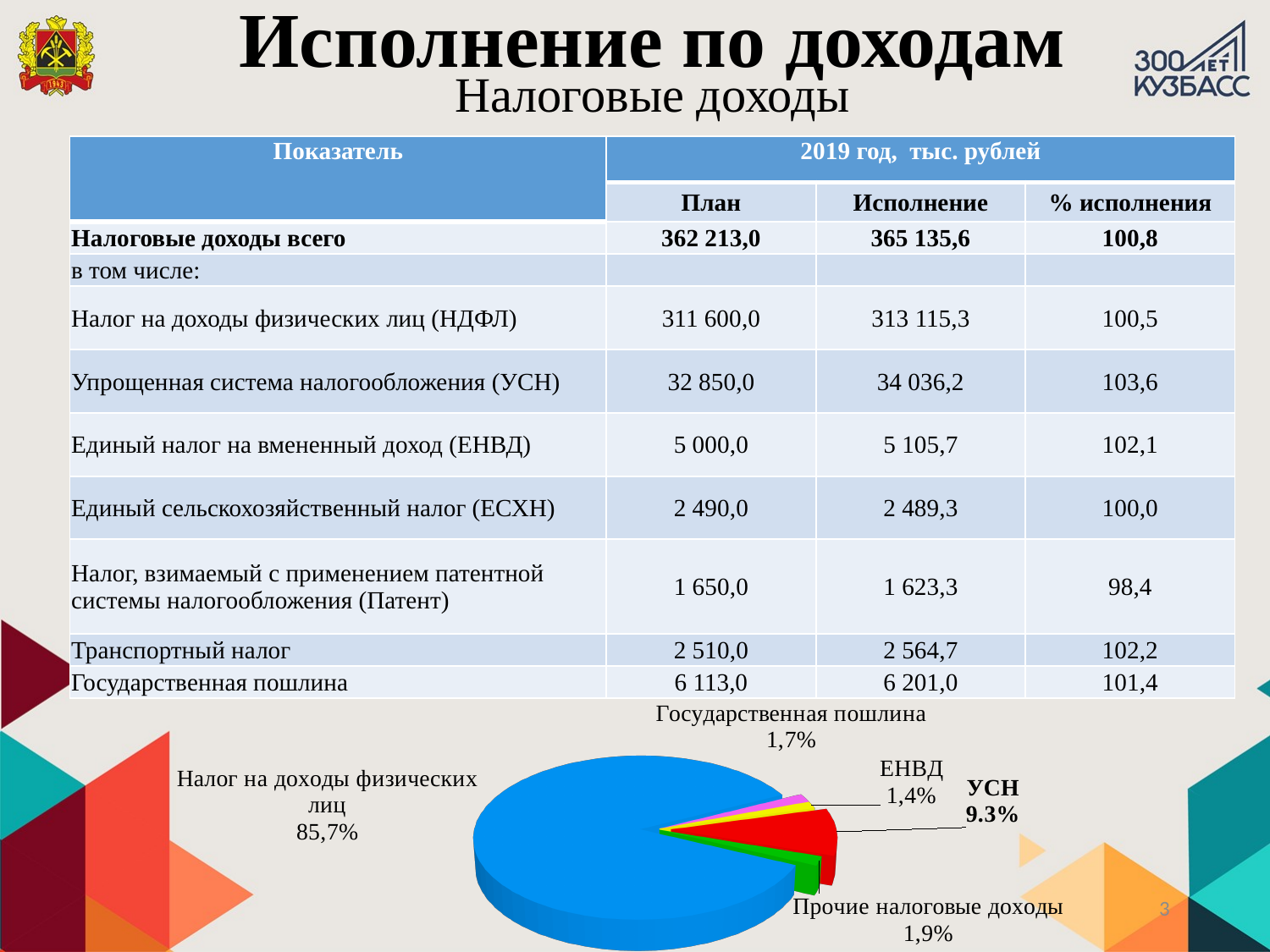
In the pie chart, what share is shown for Налог на доходы физических лиц? 85,7% In the pie chart, what is the difference in percentage points between Прочие налоговые доходы and ЕНВД? 0,5 What colour is the largest slice of the pie chart? blue How many slices does the pie chart have? 5 Which slice of the pie chart is the largest? Налог на доходы физических лиц In the pie chart, what share is shown for УСН? 9.3% What kind of chart is shown at the bottom of the slide? pie chart In the pie chart, what share is shown for Государственная пошлина? 1,7% Which slice of the pie chart is the smallest? ЕНВД In the pie chart, which is larger: Государственная пошлина or Прочие налоговые доходы? Прочие налоговые доходы